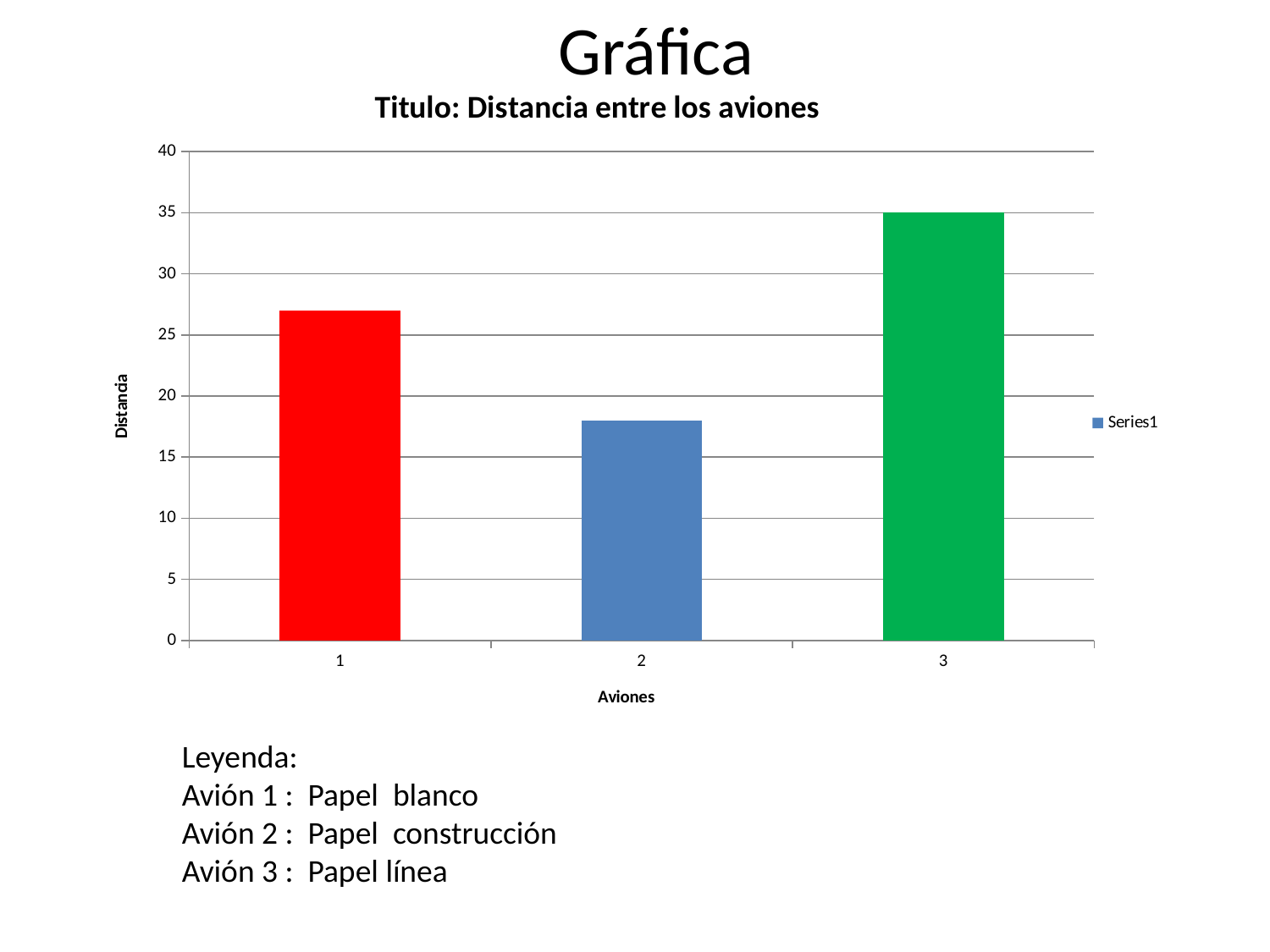
Is the distancia for avión 1 greater or less than 30? less Which avión has the highest distancia? 3 Is the distancia for avión 2 greater or less than 20? less How many bars (aviones) are plotted in the chart? 3 How many series does the legend list? 1 What is the label of the vertical axis? Distancia What is the distancia value for avión 3? 35 Which avión has the lowest distancia? 2 What is the title of the chart? Titulo: Distancia entre los aviones Which has a larger distancia, avión 1 or avión 2? avión 1 What type of chart is shown on the slide? bar chart Is the distancia for avión 1 greater or less than 25? greater